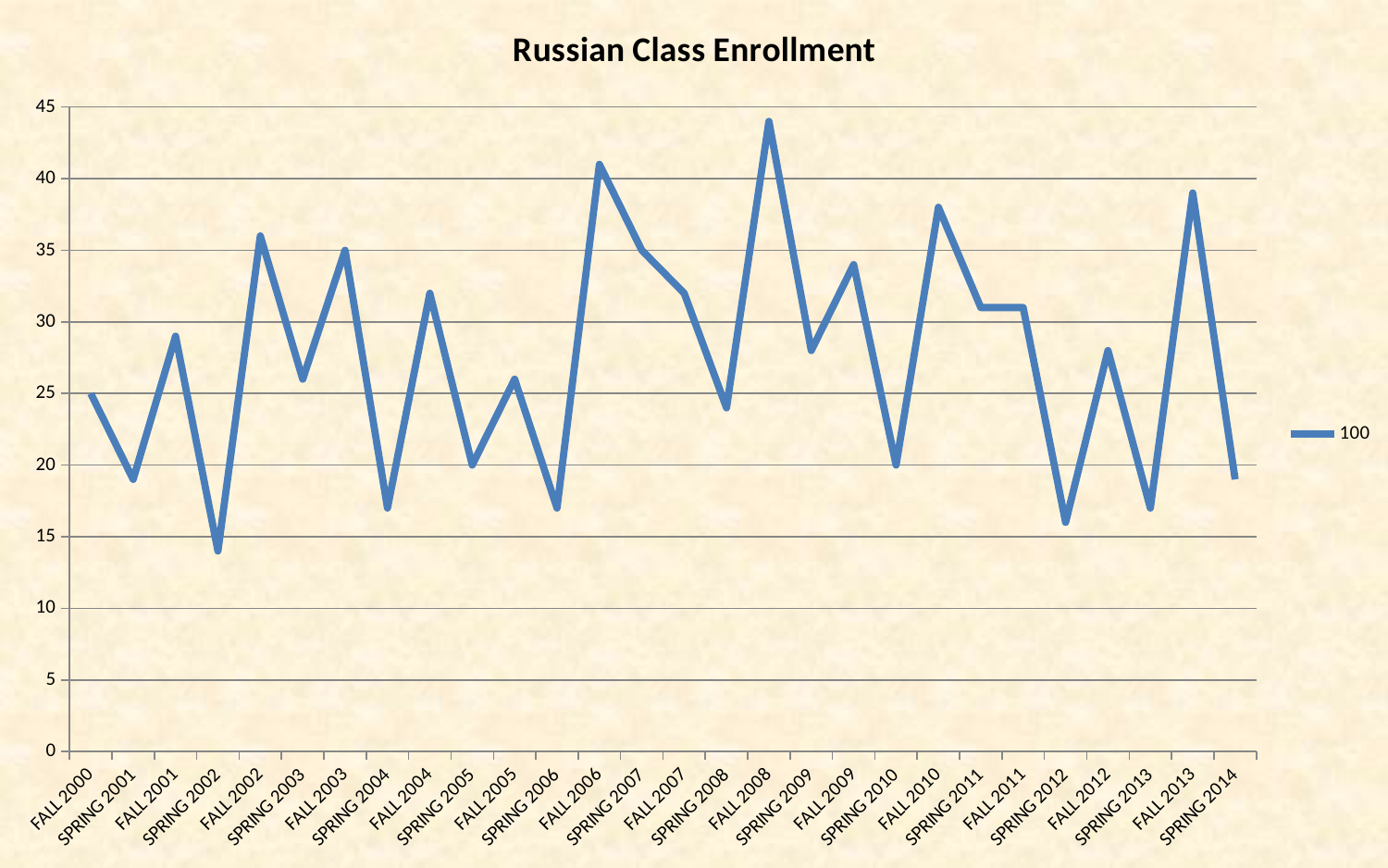
Does the enrollment rise or fall from FALL 2013 to SPRING 2014? fall What kind of chart is shown on the slide? line chart Is the value for FALL 2006 greater or less than 40? greater Is the value for SPRING 2002 greater or less than 15? less Which semester has the lowest enrollment? SPRING 2002 Is the value for SPRING 2004 greater or less than 20? less How many series does the legend list? 1 What is the title of the chart? Russian Class Enrollment How many semesters (categories) are plotted along the x axis? 28 Which is larger, the value for SPRING 2010 or the value for FALL 2010? FALL 2010 Which semester has the highest enrollment? FALL 2008